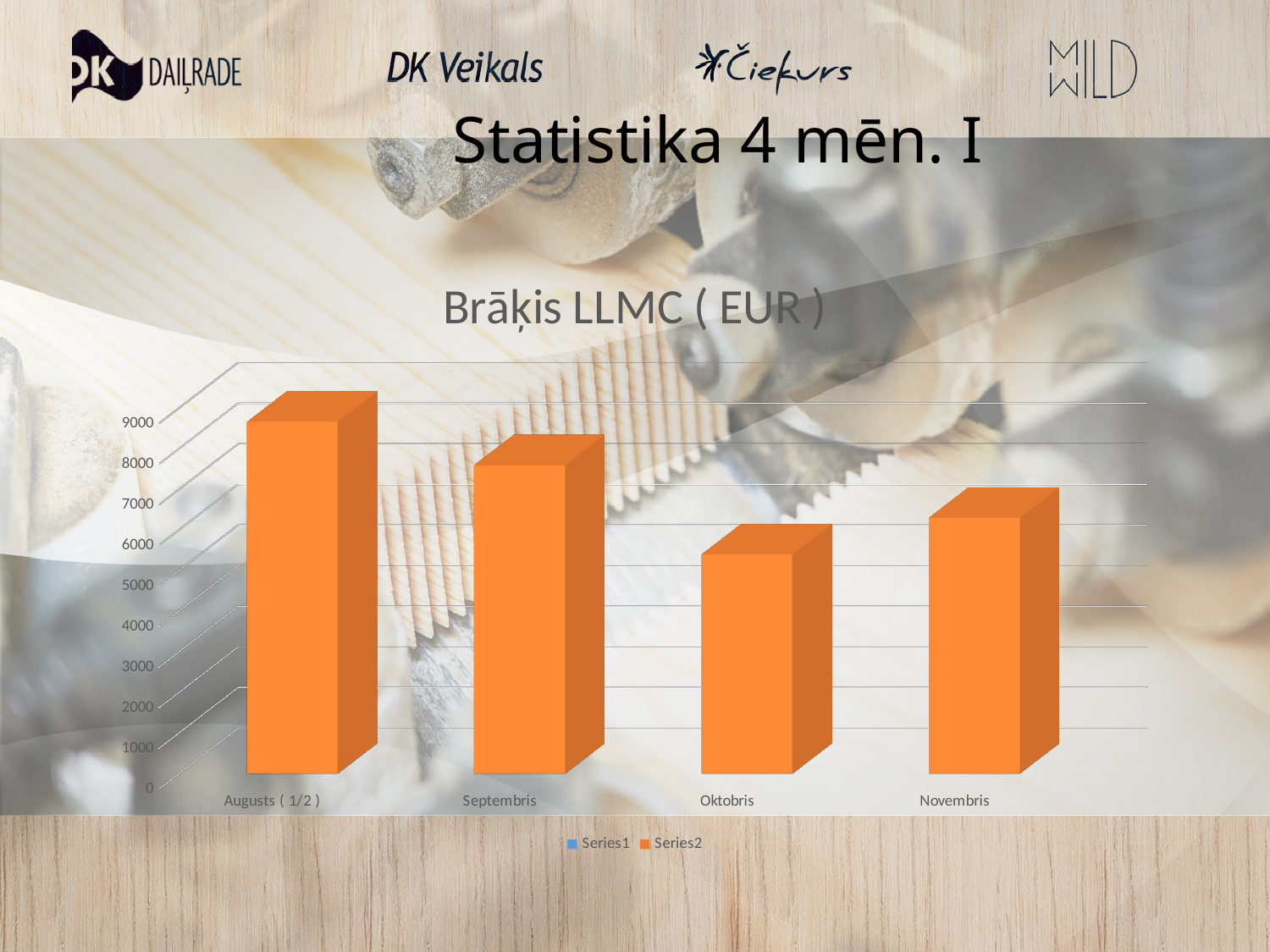
Which is larger, the value for Septembris or the value for Novembris? Septembris What is the title of the chart? Brāķis LLMC ( EUR ) Is the value for Septembris greater or less than 7000? greater Do the values rise or fall from Augusts ( 1/2 ) to Oktobris? fall How many series does the chart legend list? 2 Which category has the highest value in the chart? Augusts ( 1/2 ) Is the value for Augusts ( 1/2 ) greater or less than 8000? greater How many categories are shown on the x axis of the chart? 4 Which is larger, the value for Oktobris or the value for Augusts ( 1/2 )? Augusts ( 1/2 ) Is the value for Oktobris greater or less than 5000? greater What type of chart is shown on the slide? bar chart Which category has the lowest value in the chart? Oktobris